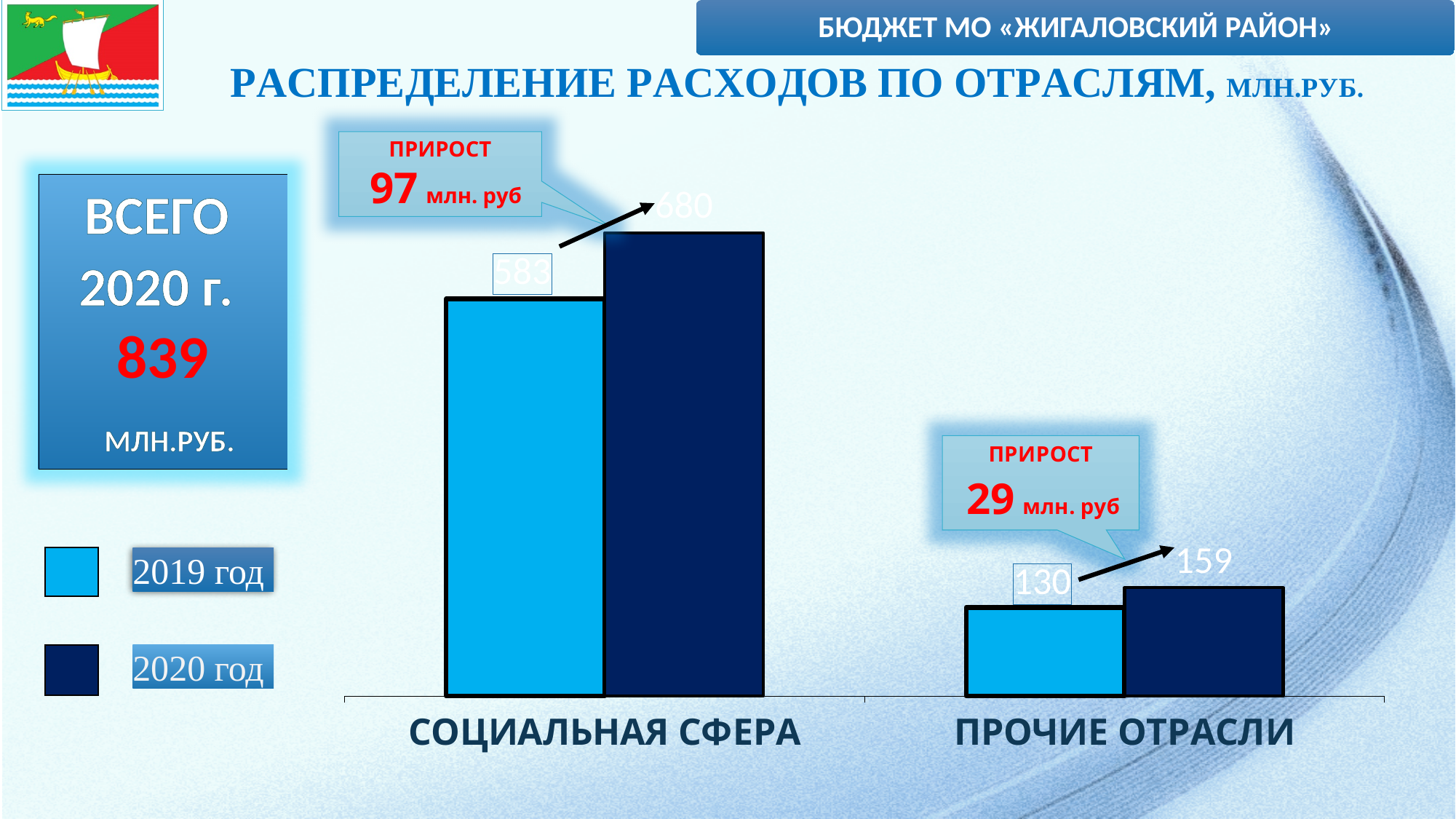
What is the difference between the 2020 год and 2019 год values for СОЦИАЛЬНАЯ СФЕРА? 97 What is the value for ПРОЧИЕ ОТРАСЛИ in 2020 год? 159 How many categories are shown on the x axis of the chart? 2 Which category has the highest value in 2020 год? СОЦИАЛЬНАЯ СФЕРА What is the difference between the 2020 год and 2019 год values for ПРОЧИЕ ОТРАСЛИ? 29 What is the value for ПРОЧИЕ ОТРАСЛИ in 2019 год? 130 What is the value for СОЦИАЛЬНАЯ СФЕРА in 2019 год? 583 Which is larger for ПРОЧИЕ ОТРАСЛИ: the 2019 год value or the 2020 год value? 2020 год What is the value for СОЦИАЛЬНАЯ СФЕРА in 2020 год? 680 How many series does the legend list? 2 Which category has the lowest value in 2019 год? ПРОЧИЕ ОТРАСЛИ What kind of chart is shown on the slide? bar chart